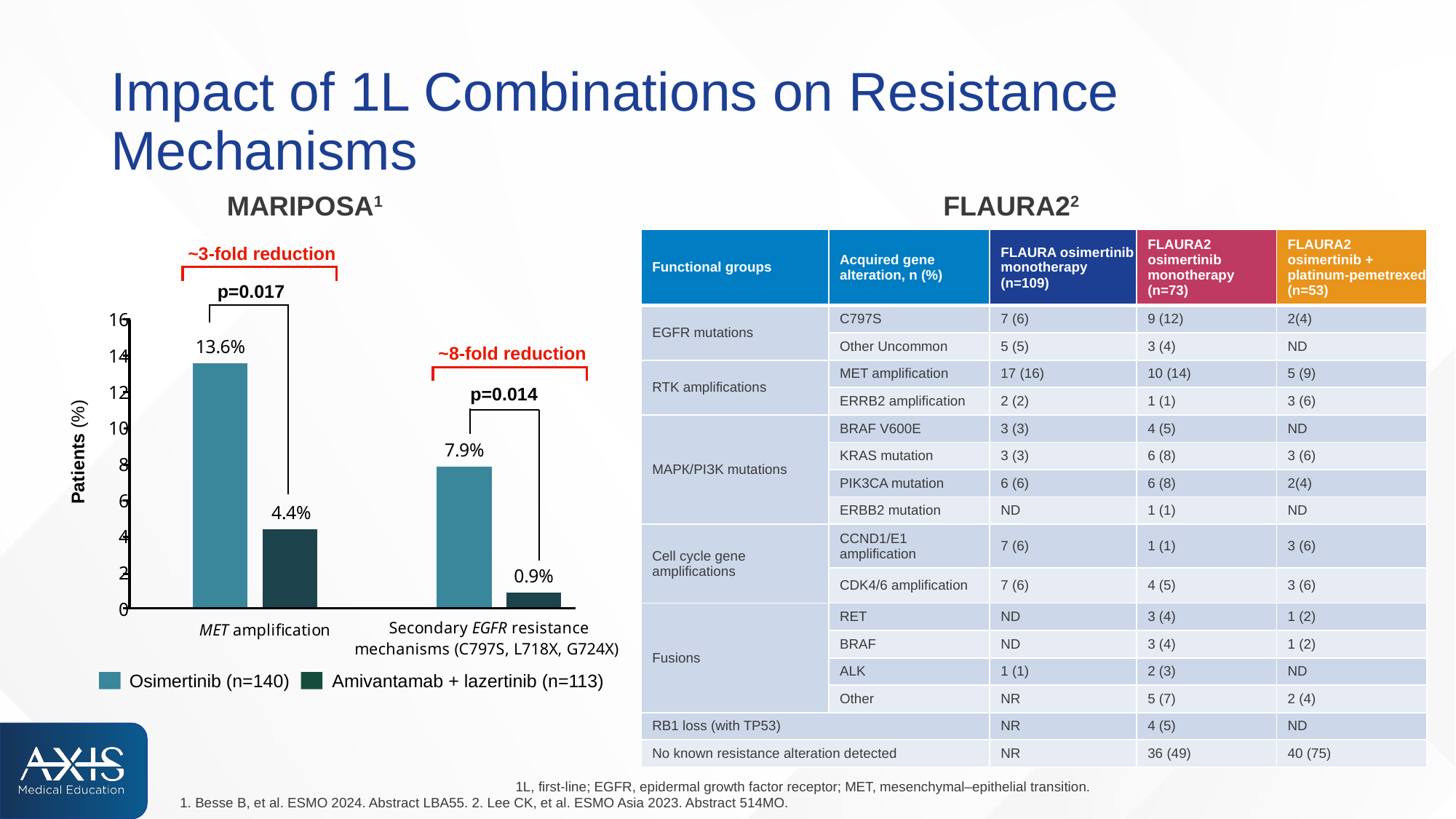
In the MARIPOSA chart, which bar is the tallest? Osimertinib, MET amplification In the MARIPOSA chart, what percentage of patients on osimertinib had MET amplification? 13.6% In the MARIPOSA chart, what is the difference in percentage points between osimertinib and amivantamab + lazertinib for secondary EGFR resistance mechanisms? 7.0 In the MARIPOSA chart, what percentage of patients on osimertinib had secondary EGFR resistance mechanisms? 7.9% In the MARIPOSA chart, what is the difference in percentage points between osimertinib and amivantamab + lazertinib for MET amplification? 9.2 In the MARIPOSA chart, which treatment has the higher rate of MET amplification? Osimertinib In the MARIPOSA chart, what percentage of patients on amivantamab + lazertinib had MET amplification? 4.4% In the MARIPOSA chart, which bar is the shortest? Amivantamab + lazertinib, secondary EGFR resistance mechanisms How many series does the legend of the MARIPOSA chart list? 2 In the MARIPOSA chart, what p-value is shown for the MET amplification comparison? p=0.017 In the MARIPOSA chart, what percentage of patients on amivantamab + lazertinib had secondary EGFR resistance mechanisms? 0.9% What type of chart is the MARIPOSA chart? Bar chart